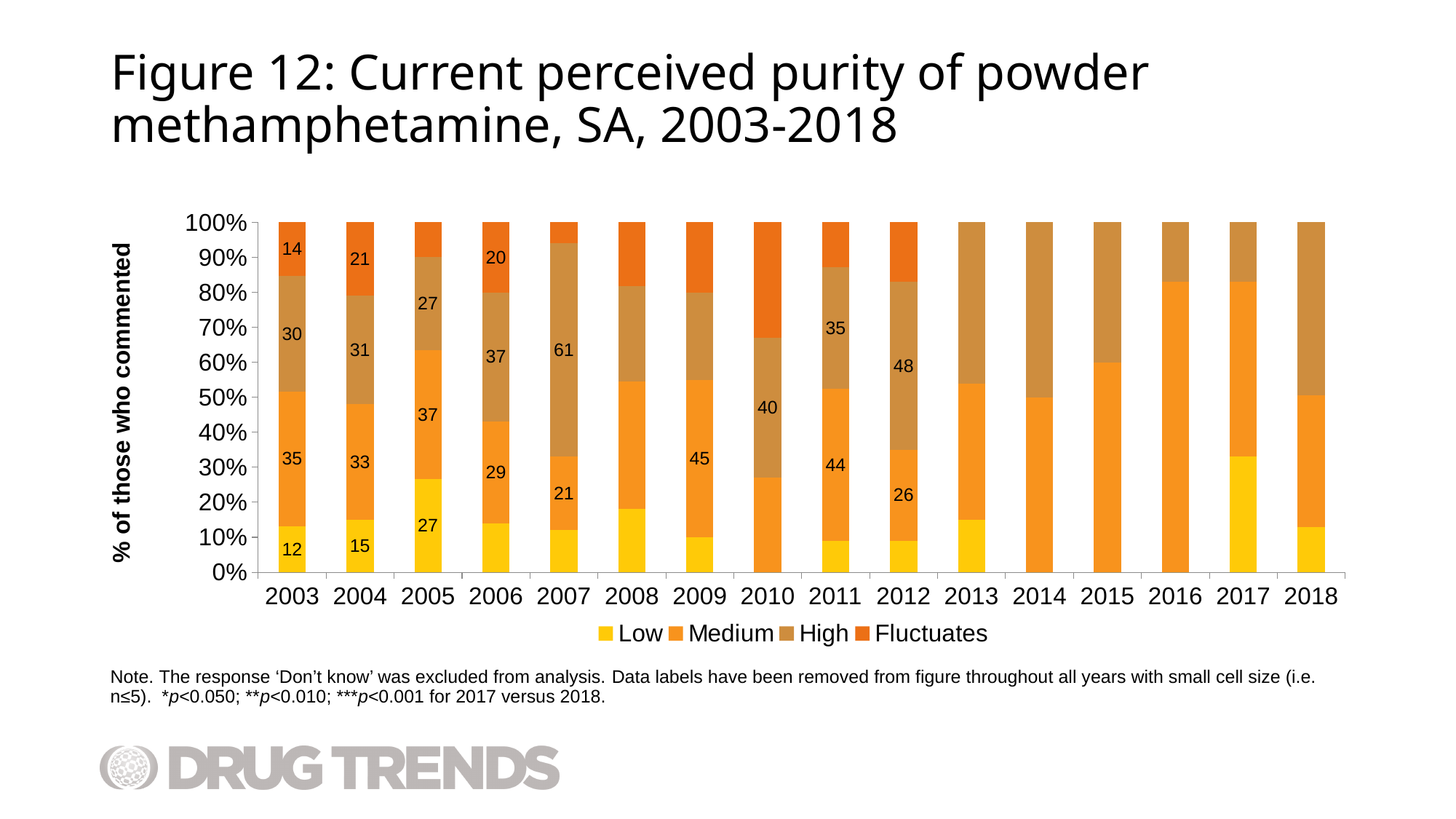
What kind of chart is shown on the slide? Stacked bar chart What is the data label for the Low segment in 2003? 12 What is the data label for the Fluctuates segment in 2004? 21 What is the data label for the Medium segment in 2012? 26 What is the difference between the Medium and Low data labels in 2003? 23 How many years are shown on the x axis? 16 How many series does the legend list? 4 Which year has the largest Low segment? 2017 In 2011, which segment is larger, Medium or High? Medium What is the data label for the High segment in 2010? 40 What is the data label for the High segment in 2007? 61 Is the Low segment for 2017 greater or less than 20%? greater